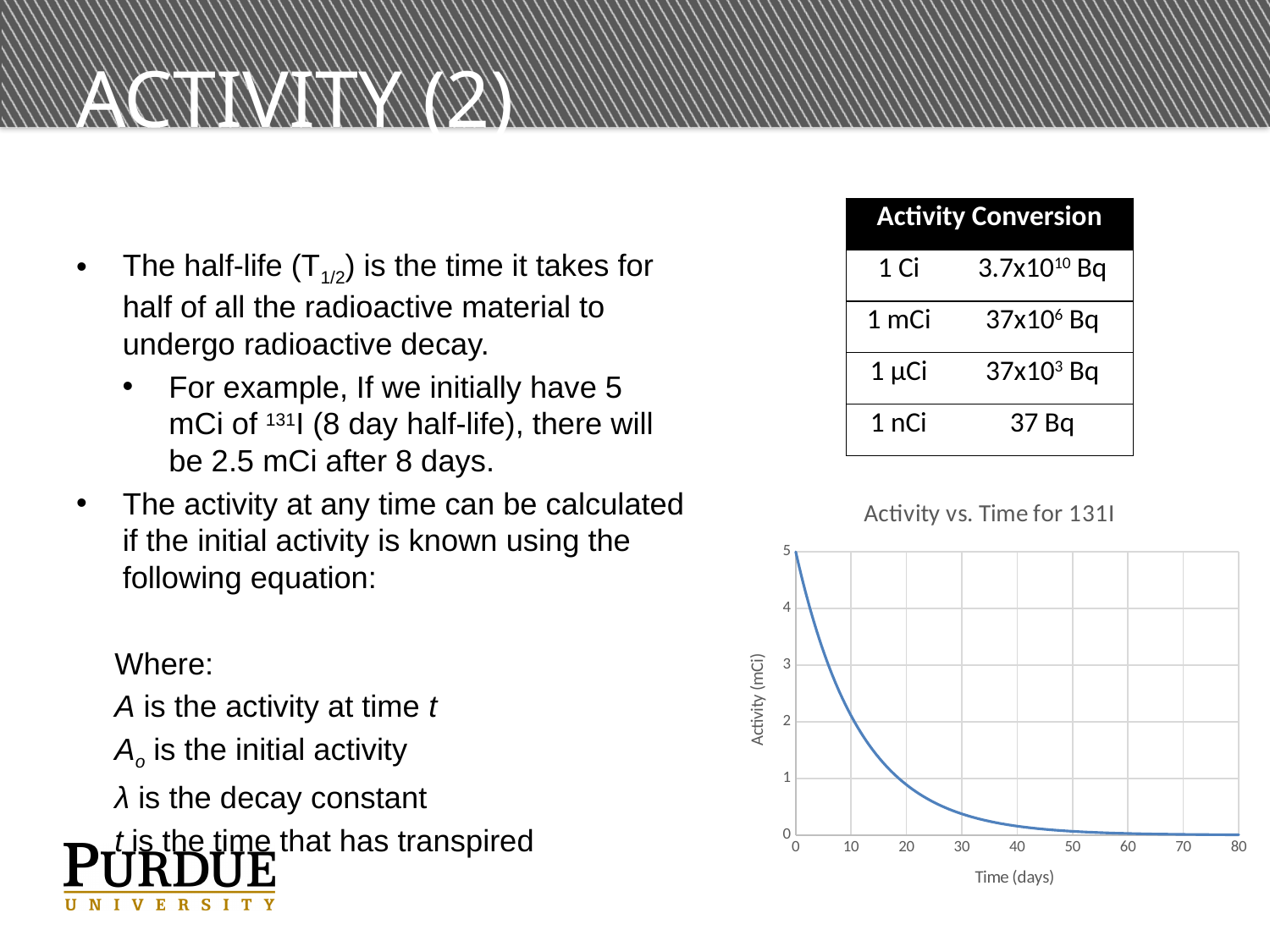
What kind of chart is shown on the slide? line chart What is the label of the y axis of the chart? Activity (mCi) Is the activity at 60 days greater or less than 1? less Is the activity at 40 days greater or less than 1? less At what time on the x axis is the activity highest? 0 Do the values on the chart rise or fall as time increases along the x axis? fall Is the activity at 10 days greater or less than 1? greater What is the title of the chart? Activity vs. Time for 131I Which is larger, the activity at 10 days or the activity at 30 days? 10 days What is the activity shown on the chart at time 0 days? 5 At what time on the x axis is the activity lowest? 80